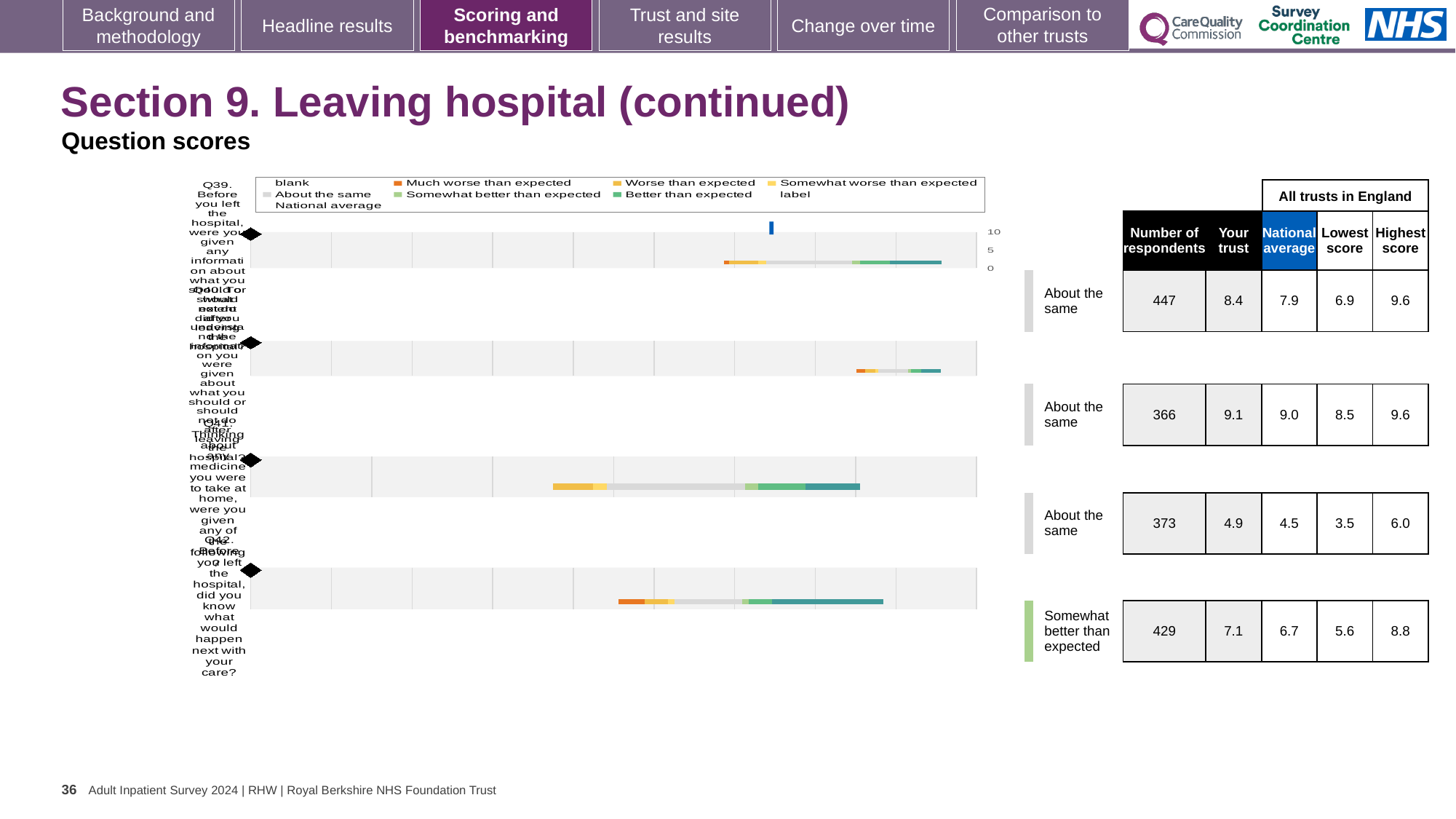
What is the 'Your trust' score for the first (top) question row? 8.4 How many question rows (bars) are plotted in the chart? 4 What benchmark category label is shown for the fourth (bottom) question row? Somewhat better than expected For the third question row, which is larger: the 'Your trust' score or the national average? Your trust How many of the question rows are labelled 'About the same'? 3 What is the highest score across all trusts in England for the fourth (bottom) question row? 8.8 Which question row has the lowest 'Your trust' score? the third row (4.9) For the first question row, what is the difference between the 'Your trust' score and the national average? 0.5 Which question row has the highest 'Your trust' score? the second row (9.1) What kind of chart is shown on the slide? bar chart What is the national average for the second question row? 9.0 How many respondents are listed for the third question row? 373